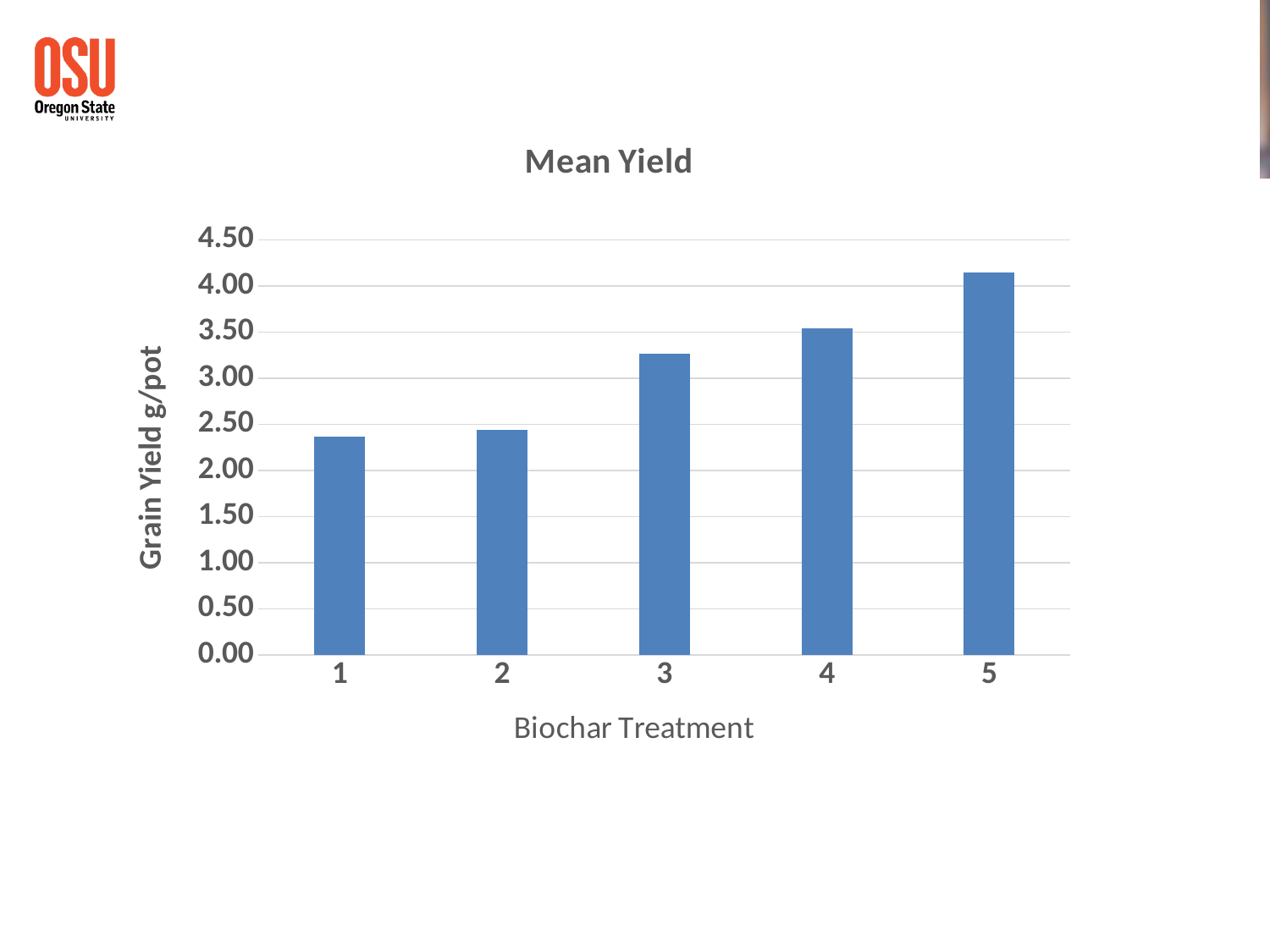
What kind of chart is shown on the slide? bar chart What is the title of the chart? Mean Yield Is the value for biochar treatment 1 greater or less than 2.50? less Which has the larger mean yield, biochar treatment 4 or biochar treatment 5? 5 Is the value for biochar treatment 3 greater or less than 3.00? greater What is the label on the vertical axis of the chart? Grain Yield g/pot How many biochar treatments are plotted on the chart? 5 Which has the larger mean yield, biochar treatment 1 or biochar treatment 3? 3 Do the mean yield values rise or fall as the biochar treatment number increases from 1 to 5? rise Is the value for biochar treatment 5 greater or less than 4.00? greater Which biochar treatment has the highest mean yield? 5